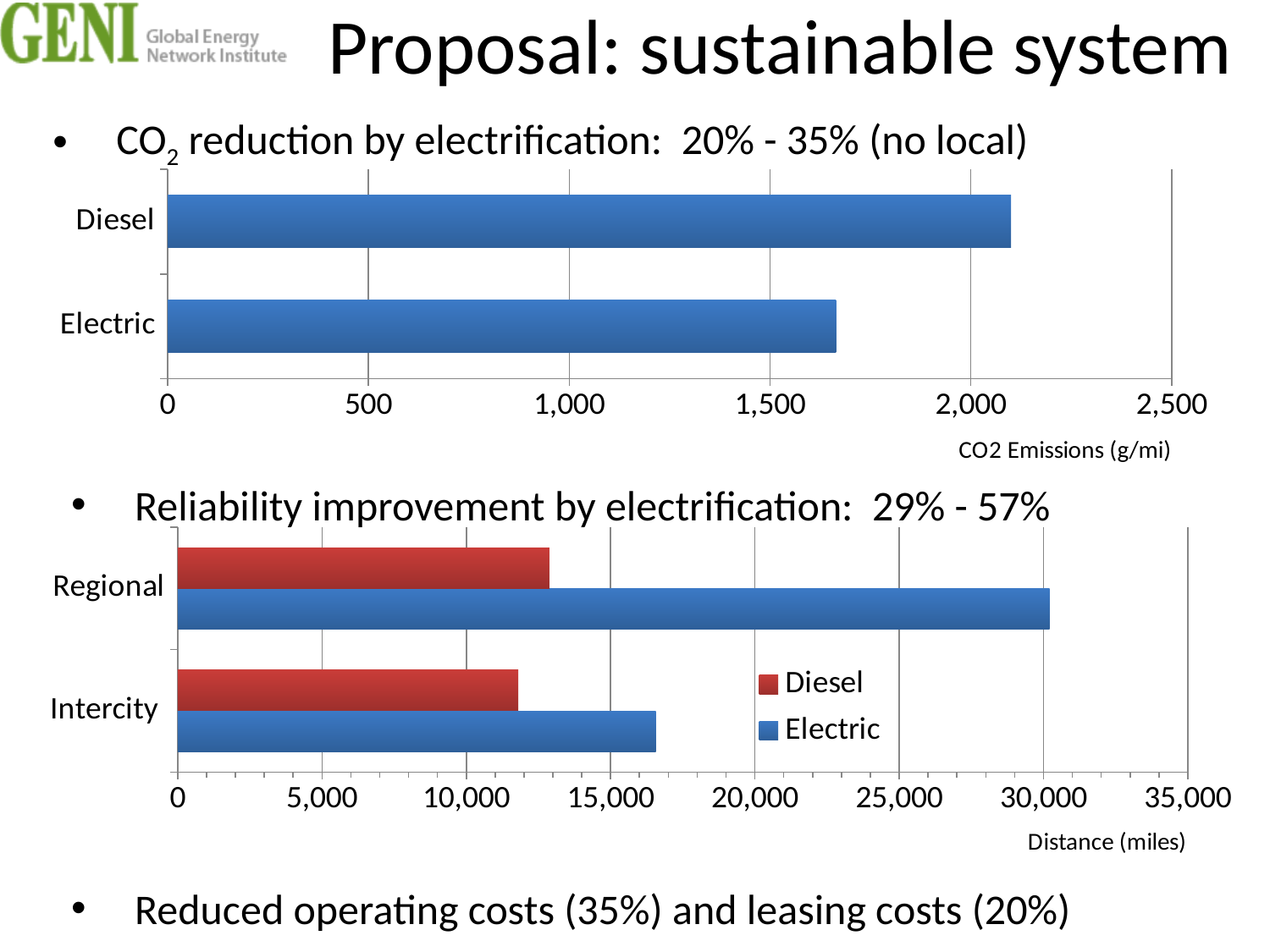
In the top chart, what is the x-axis title? CO2 Emissions (g/mi) In the top chart (CO2 Emissions), is the value for Diesel greater or less than 2,000? greater In the top chart (CO2 Emissions), which category has the higher value? Diesel In the bottom chart (Distance), which is larger for Intercity, Diesel or Electric? Electric In the top chart (CO2 Emissions), is the value for Electric greater or less than 1,500? greater In the bottom chart (Distance), is the Diesel value for Intercity greater or less than 15,000? less In the top chart (CO2 Emissions), what kind of chart is shown? bar chart In the bottom chart (Distance), how many series does the legend list? 2 In the top chart (CO2 Emissions), how many categories are plotted? 2 In the bottom chart (Distance), which category and series has the highest value? Regional, Electric In the bottom chart, what colour represents the Diesel series? red